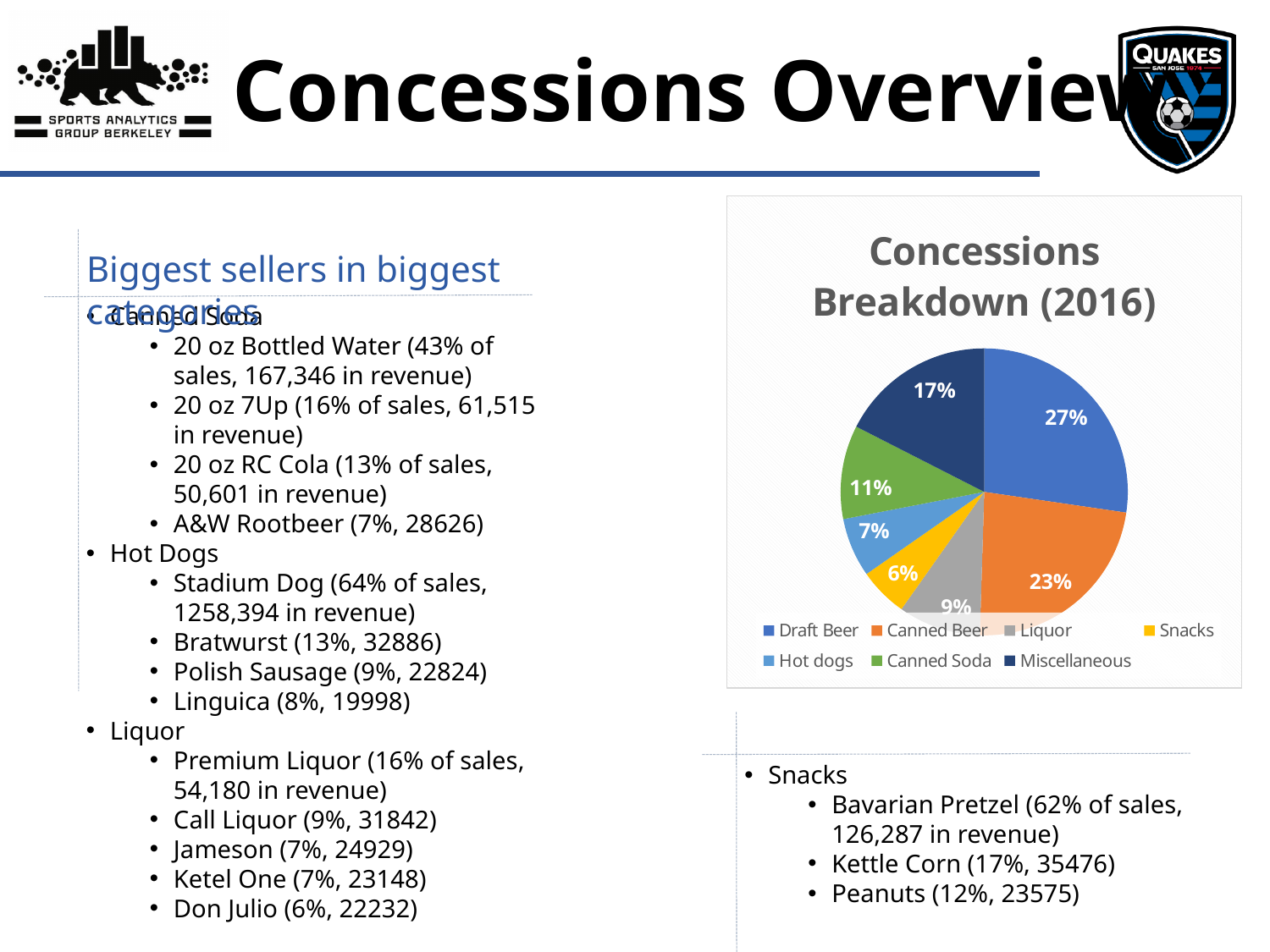
Which category has the smallest share of the pie? Snacks What is the title of the chart? Concessions Breakdown (2016) How many categories does the pie chart show? 7 What type of chart is shown on the slide? Pie chart What share of the pie does Canned Soda account for? 11% Which category is shown in green in the pie chart? Canned Soda What is the difference in percentage points between Draft Beer and Canned Beer? 4 What share of the pie does Draft Beer account for? 27% What share of the pie does Canned Beer account for? 23% Which category has the largest share of the pie? Draft Beer Which has a larger share, Liquor or Hot dogs? Liquor